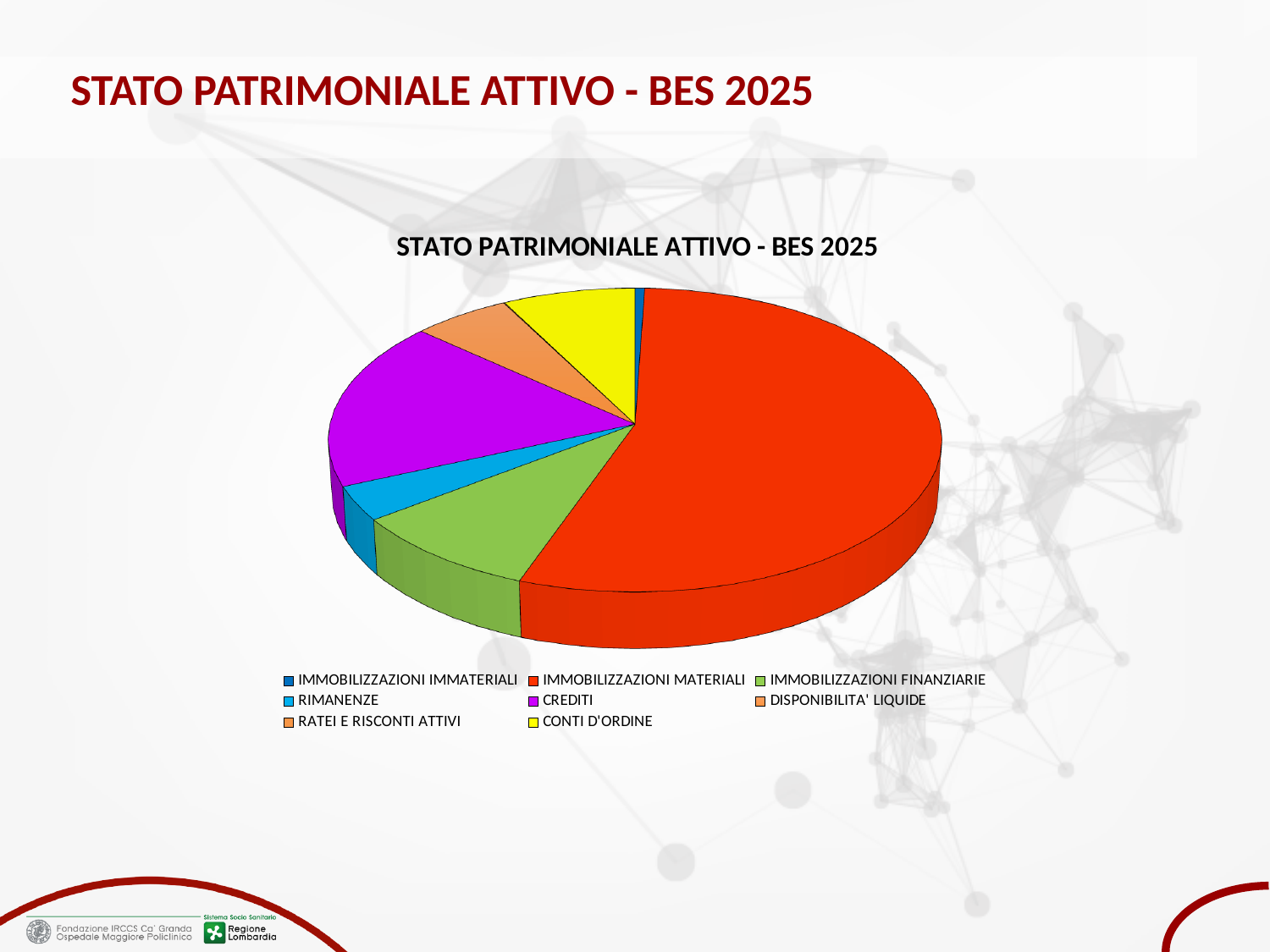
What kind of chart is shown on the slide? pie chart Which category has the largest slice of the pie? IMMOBILIZZAZIONI MATERIALI Which slice is larger, CREDITI or CONTI D'ORDINE? CREDITI How many categories does the legend of the pie chart list? 8 Which slice is larger, IMMOBILIZZAZIONI MATERIALI or CREDITI? IMMOBILIZZAZIONI MATERIALI What is the title of the chart? STATO PATRIMONIALE ATTIVO - BES 2025 Which slice is larger, IMMOBILIZZAZIONI FINANZIARIE or CONTI D'ORDINE? IMMOBILIZZAZIONI FINANZIARIE Does IMMOBILIZZAZIONI MATERIALI account for more or less than half of the pie? more Which colour represents CREDITI in the pie chart? purple